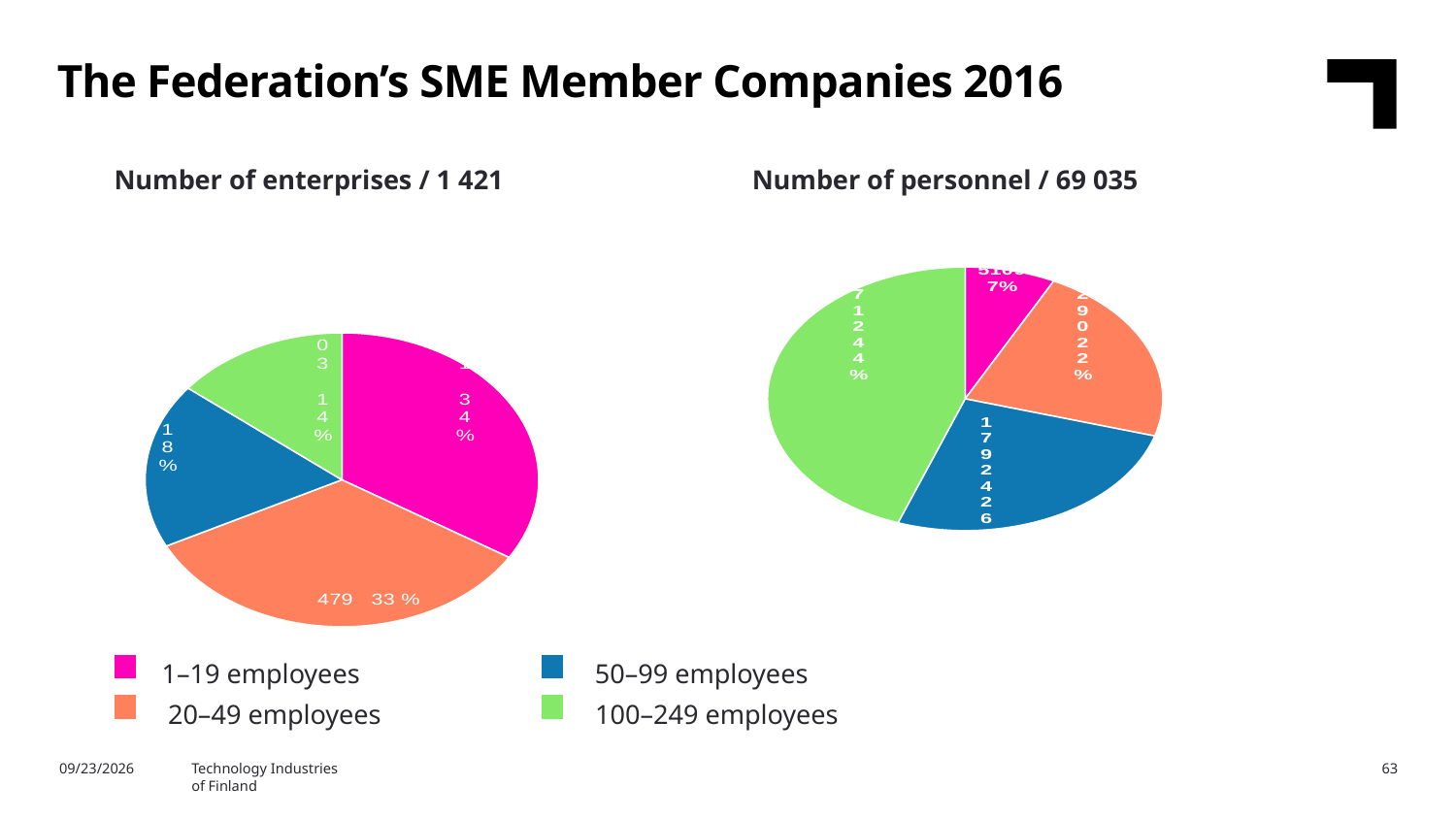
In the 'Number of enterprises / 1 421' chart, what is the difference in percentage points between the 1–19 employees share and the 100–249 employees share? 20 percentage points In the 'Number of personnel / 69 035' chart, what share do companies with 1–19 employees have? 7% In the 'Number of personnel / 69 035' chart, which category has the smallest share? 1–19 employees In the 'Number of enterprises / 1 421' chart, what share do companies with 50–99 employees have? 18 % In the 'Number of enterprises / 1 421' chart, what share do companies with 1–19 employees have? 34 % In the 'Number of enterprises / 1 421' chart, which is larger: the share for 50–99 employees or for 100–249 employees? 50–99 employees How many categories does the legend list? 4 In the 'Number of enterprises / 1 421' chart, which category has the smallest share? 100–249 employees What kind of charts are shown on the slide? Pie charts In the 'Number of personnel / 69 035' chart, which category has the largest share? 100–249 employees In the 'Number of enterprises / 1 421' chart, how many enterprises have 20–49 employees? 479